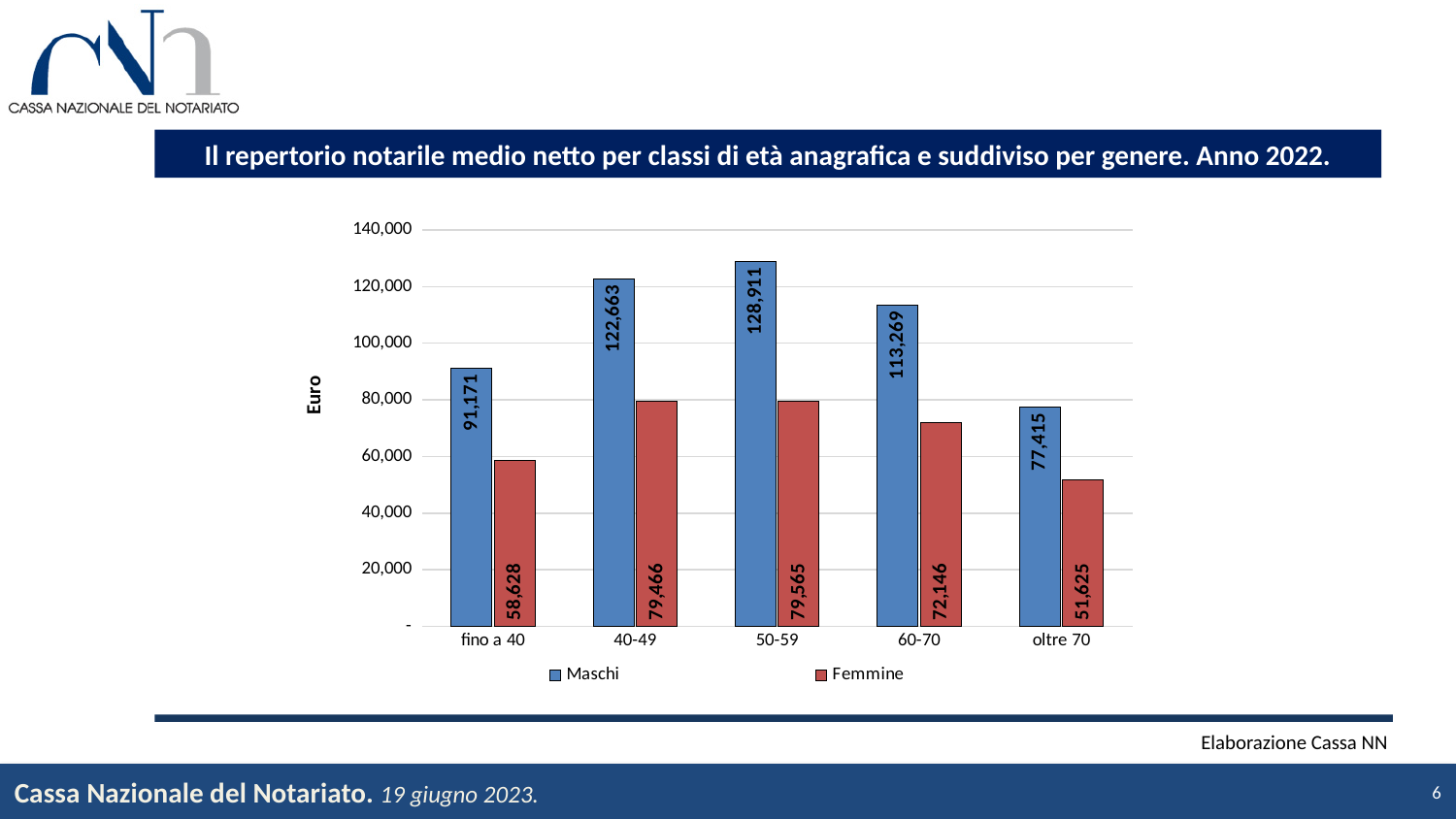
What is the value for Femmine in the 60-70 age class? 72,146 What kind of chart is shown on the slide? bar chart Which age class has the lowest value for Femmine? oltre 70 Which age class has the highest value for Maschi? 50-59 What is the value for Femmine in the fino a 40 age class? 58,628 What is the difference between the Maschi and Femmine values in the 50-59 age class? 49,346 Which is larger in the 40-49 age class, the Maschi value or the Femmine value? Maschi How many series does the legend list? 2 What is the value for Maschi in the 50-59 age class? 128,911 How many age classes are shown on the x axis? 5 Is the value for Femmine in the 40-49 age class greater or less than 60,000? greater What is the value for Maschi in the oltre 70 age class? 77,415